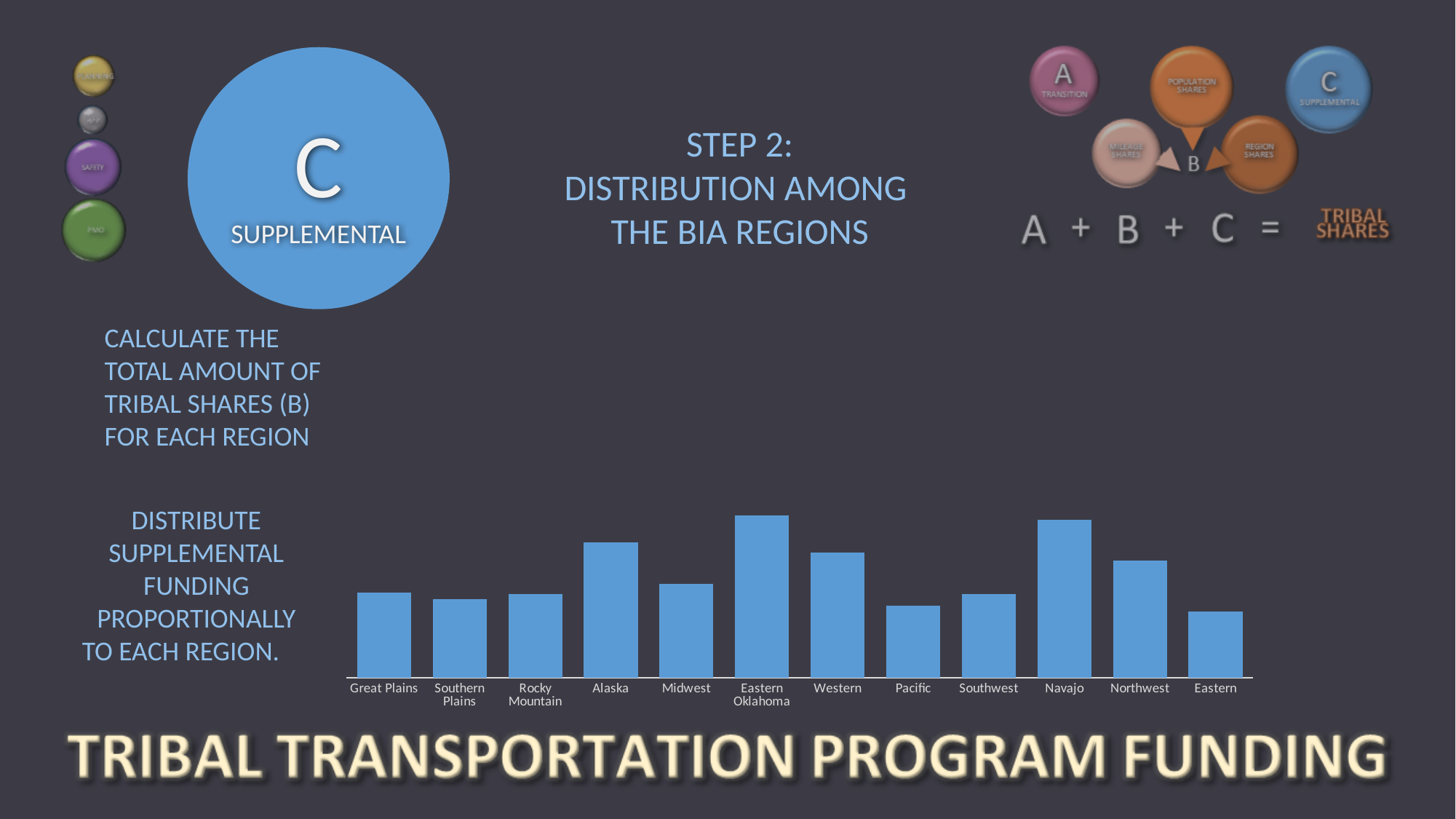
What colour are the bars in the chart? blue Which has the taller bar, Midwest or Southern Plains? Midwest Which has the taller bar, Southwest or Northwest? Northwest Which has the taller bar, Alaska or Midwest? Alaska How many regions are shown on the x axis of the bar chart? 12 Which region is the first category on the x axis of the bar chart? Great Plains What kind of chart is shown on the slide? bar chart